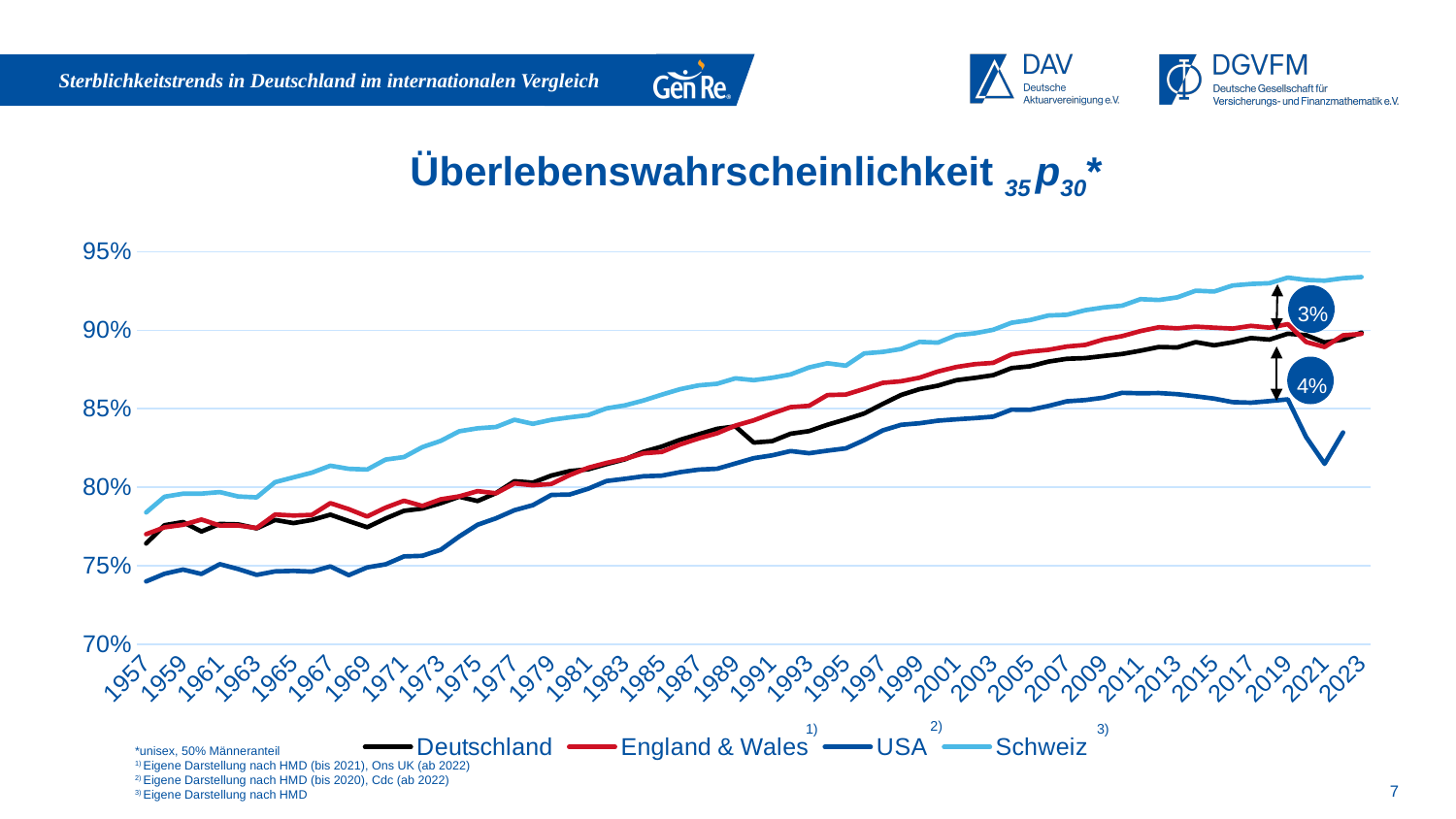
How many series does the legend list? 4 Is the value for Deutschland in 1957 greater or less than 80%? less Does the Schweiz series generally rise or fall from 1957 to 2023? rise What percentage is shown in the upper circle annotation near the right end of the chart? 3% Is the value for Schweiz in 2023 greater or less than 90%? greater What is the title of the chart? Überlebenswahrscheinlichkeit 35p30* Which is higher in 1957, Deutschland or USA? Deutschland What kind of chart is shown on the slide? line chart Which series is highest in 2023? Schweiz What percentage is shown in the lower circle annotation near the right end of the chart? 4% Is the value for USA in 2021 greater or less than 85%? less